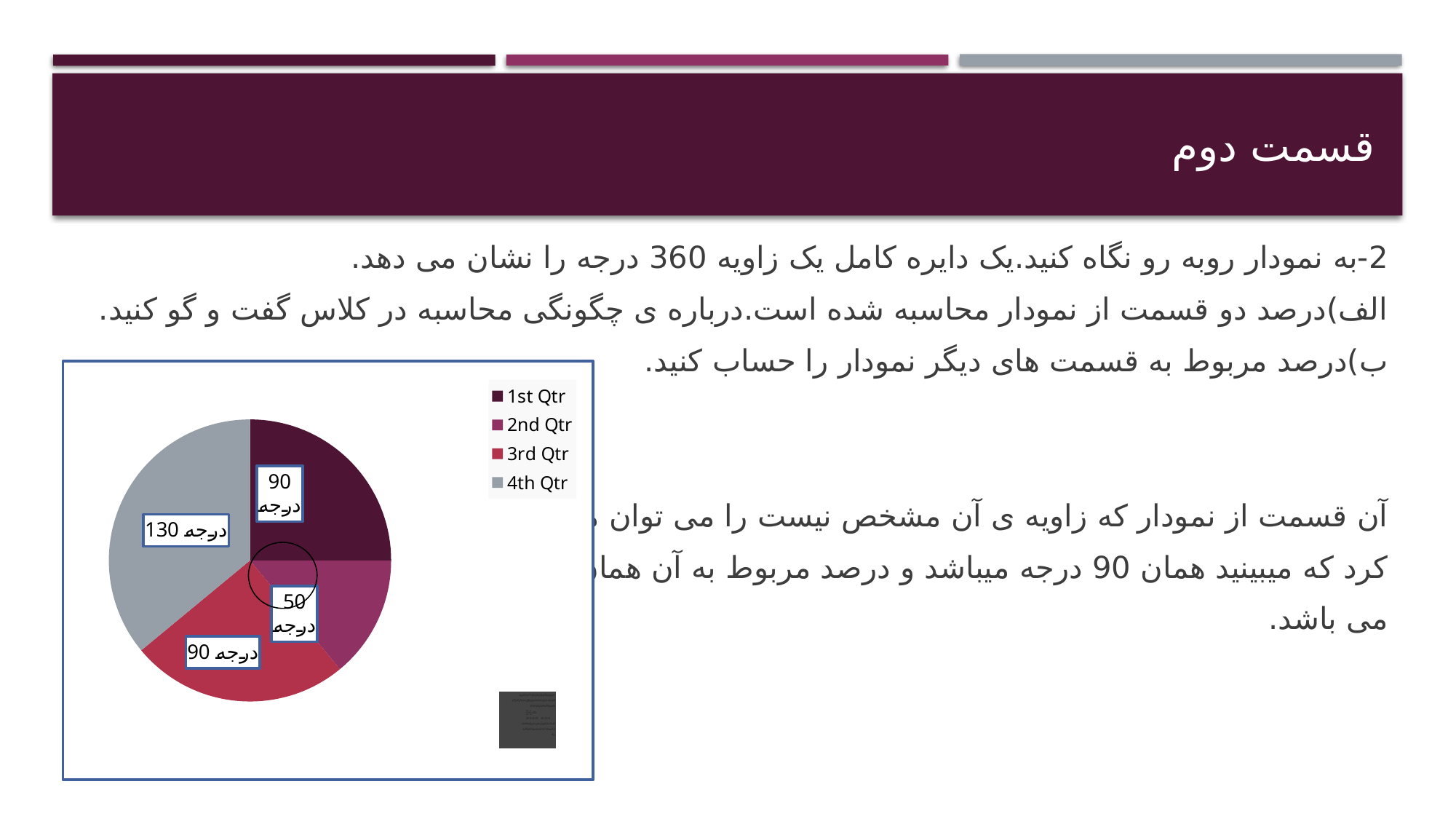
Which slice of the pie chart has the largest angle? 4th Qtr What share of the pie does the 1st Qtr slice (90 degrees) represent? 25% What angle is labelled on the 1st Qtr slice of the pie chart? 90 درجه How many entries does the legend of the pie chart list? 4 What kind of chart is shown on the slide? pie chart What angle is labelled on the 2nd Qtr slice of the pie chart? 50 درجه What colour is the 4th Qtr slice in the pie chart? gray How many slices does the pie chart have? 4 What angle is labelled on the 4th Qtr slice of the pie chart? 130 درجه Which slice of the pie chart has the smallest angle? 2nd Qtr Which slice is larger, 3rd Qtr or 2nd Qtr? 3rd Qtr What is the difference in degrees between the 4th Qtr slice and the 2nd Qtr slice? 80